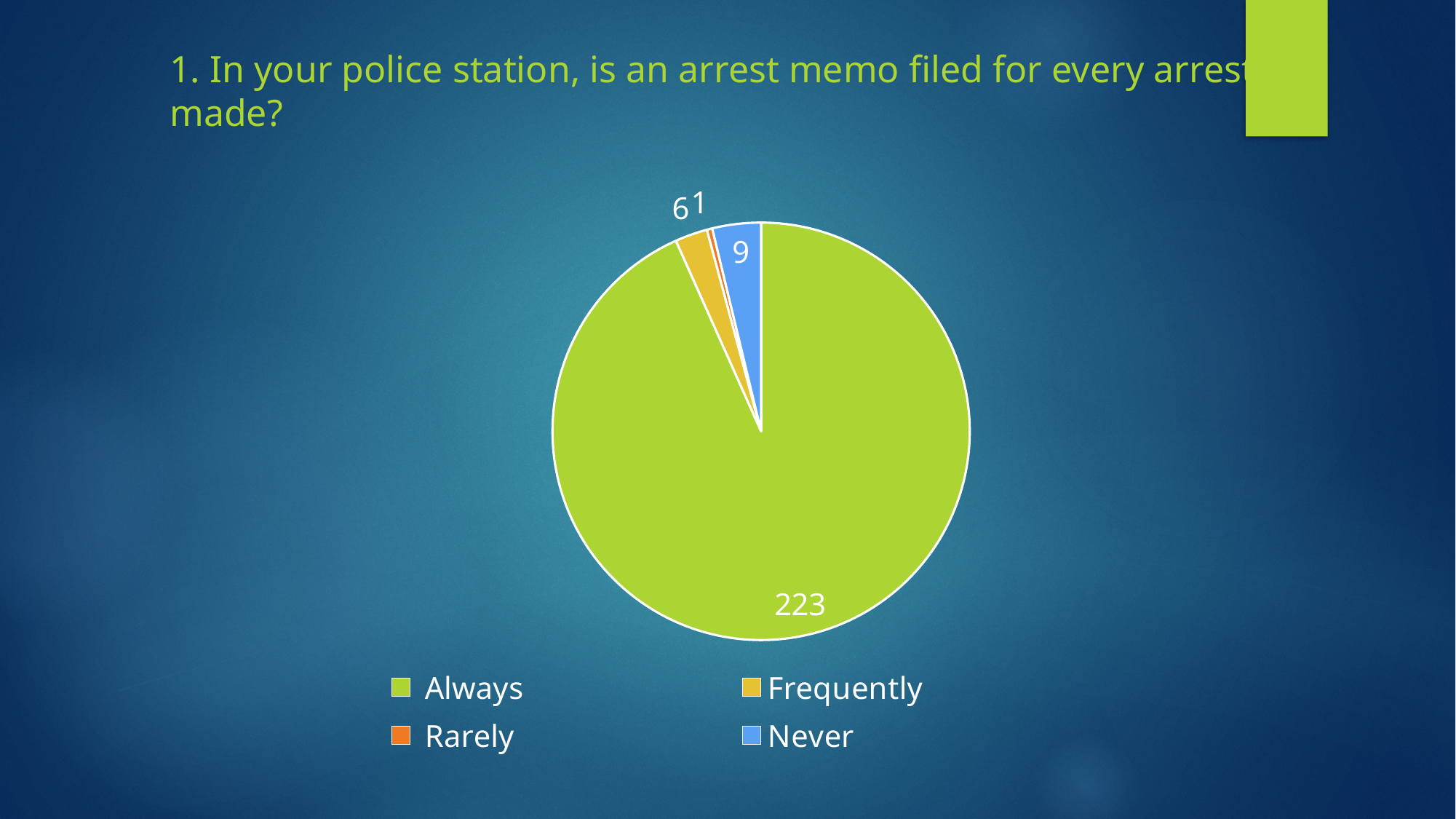
What value is shown for the Never slice? 9 Which category has the largest slice of the pie? Always What value is shown for the Rarely slice? 1 What is the total of all the slice values in the pie chart? 239 What value is shown for the Always slice? 223 What colour is the Never slice in the pie chart? Blue How many categories does the pie chart show? 4 Which category has the smallest slice of the pie? Rarely What value is shown for the Frequently slice? 6 What kind of chart is shown on the slide? Pie chart What is the difference between the Always value and the Never value? 214 Which is larger, the Never slice or the Frequently slice? Never